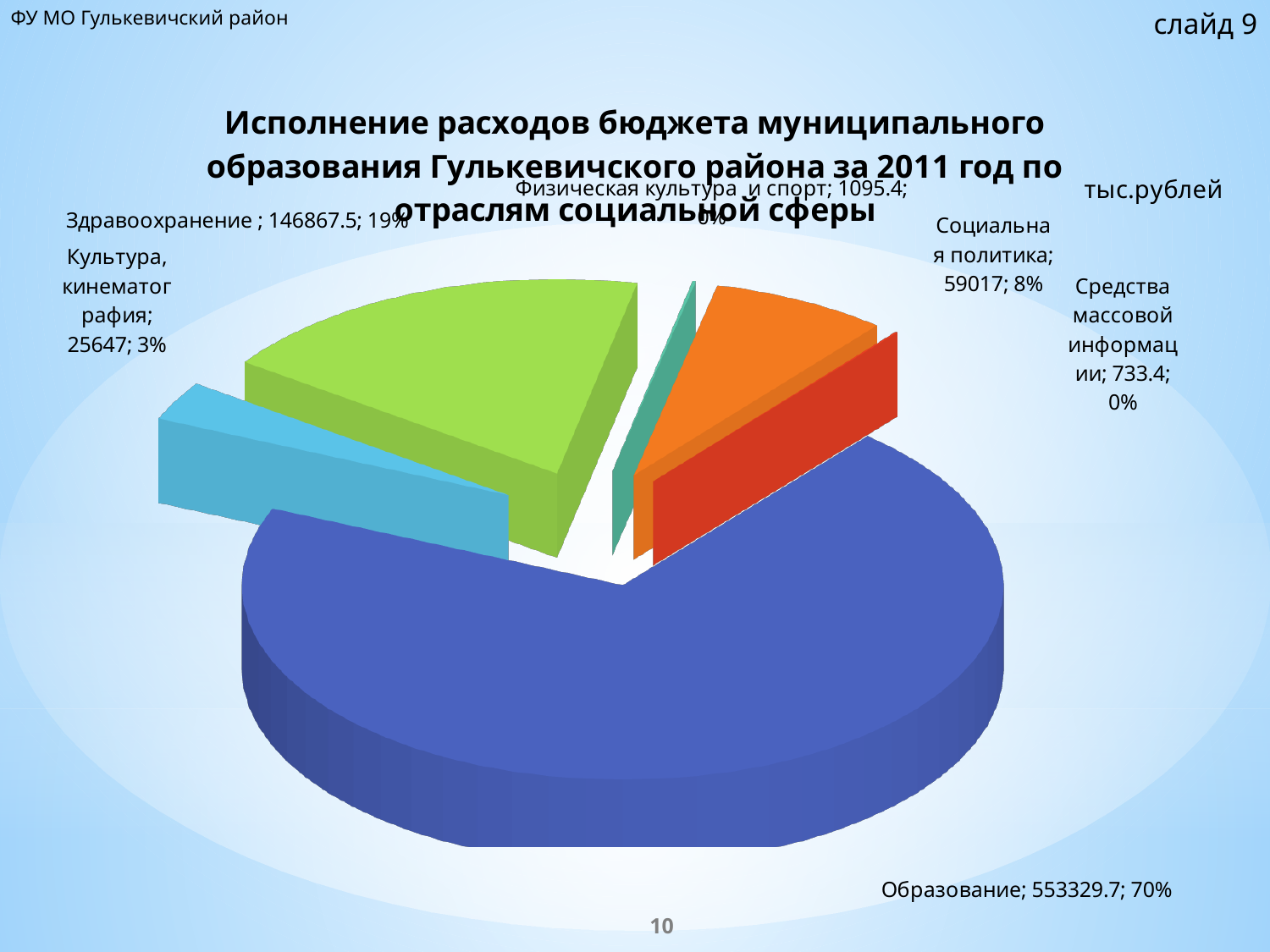
What is the value for Культура, кинематография? 25647 What kind of chart is shown on the slide? Pie chart What share of the pie does Образование represent? 70% What share of the pie does Здравоохранение represent? 19% What is the value for Образование? 553329.7 How many categories does the pie chart show? 6 Which category has the smallest value? Средства массовой информации What is the difference between the values for Здравоохранение and Социальная политика? 87850.5 What is the value for Средства массовой информации? 733.4 What is the value for Здравоохранение? 146867.5 What is the value for Социальная политика? 59017 Which category has the largest slice of the pie? Образование